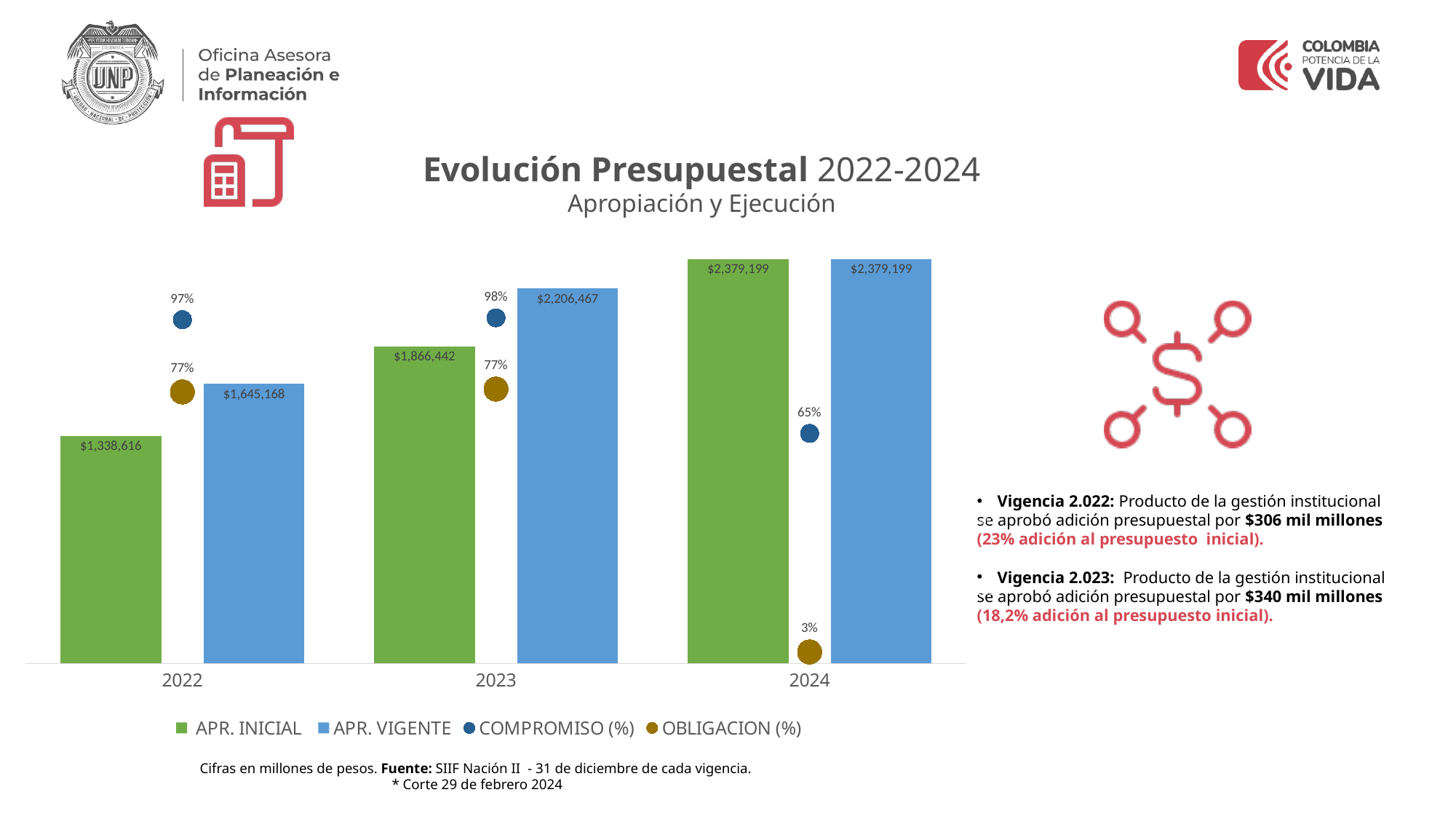
What is the difference between APR. VIGENTE and APR. INICIAL in 2022? $306,552 What is the APR. VIGENTE value for 2023? $2,206,467 What is the OBLIGACION (%) value for 2023? 77% Which year has the lowest OBLIGACION (%) value? 2024 What is the COMPROMISO (%) value for 2024? 65% Does the APR. INICIAL value rise or fall from 2022 to 2024? rise How many series does the chart legend list? 4 Which year has the highest APR. VIGENTE value? 2024 What is the difference between APR. VIGENTE and APR. INICIAL in 2023? $340,025 Which is larger in 2022, the COMPROMISO (%) or the OBLIGACION (%)? COMPROMISO (%) How many years are shown on the x axis of the chart? 3 What is the APR. INICIAL value for 2022? $1,338,616